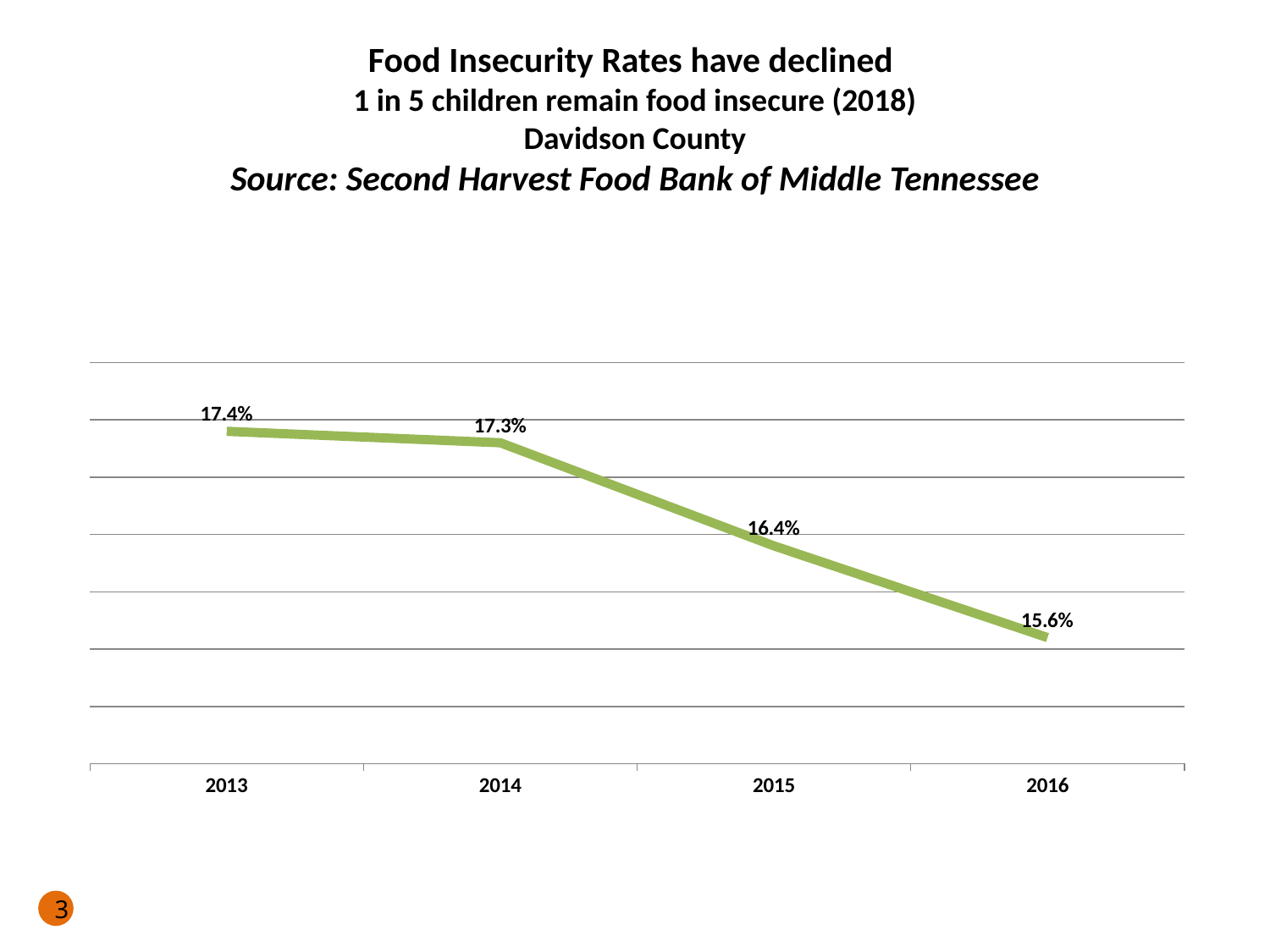
Which year has the highest food insecurity rate? 2013 How many years are plotted on the chart? 4 Do the values rise or fall from 2013 to 2016? Fall What is the food insecurity rate shown for 2014? 17.3% What is the difference between the 2014 rate and the 2015 rate? 0.9% Which year has the lowest food insecurity rate? 2016 What is the difference between the 2013 rate and the 2016 rate? 1.8% Which year has a higher rate, 2015 or 2016? 2015 What is the food insecurity rate shown for 2013? 17.4% What kind of chart is shown on the slide? Line chart What is the food insecurity rate shown for 2016? 15.6% What is the food insecurity rate shown for 2015? 16.4%